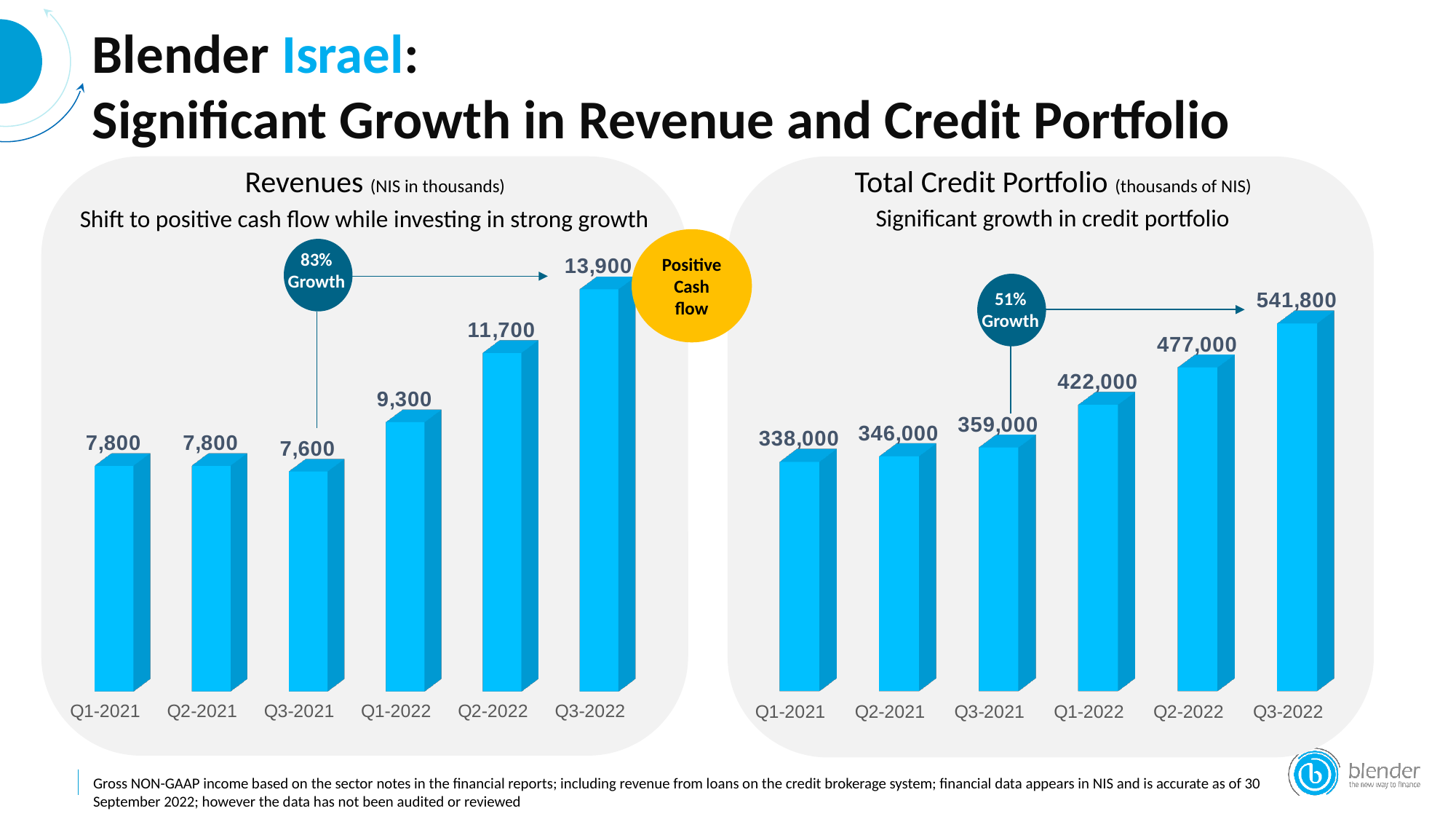
In the Total Credit Portfolio chart, do the values rise or fall from Q1-2021 to Q3-2022? Rise In the Total Credit Portfolio chart, which quarter has the highest value? Q3-2022 In the Total Credit Portfolio chart, what is the value for Q3-2022? 541,800 In the Revenues chart, which quarter has the lowest value? Q3-2021 In the Total Credit Portfolio chart, which is larger, Q2-2022 or Q1-2022? Q2-2022 What kind of chart is the Total Credit Portfolio chart? Bar chart In the Total Credit Portfolio chart, what is the value for Q2-2021? 346,000 In the Revenues chart, what is the value for Q3-2022? 13,900 In the Revenues chart, how many quarters are shown? 6 In the Revenues chart, what is the value for Q1-2022? 9,300 In the Revenues chart, what is the difference between Q3-2022 and Q2-2022? 2,200 In the Total Credit Portfolio chart, what is the difference between Q1-2022 and Q3-2021? 63,000